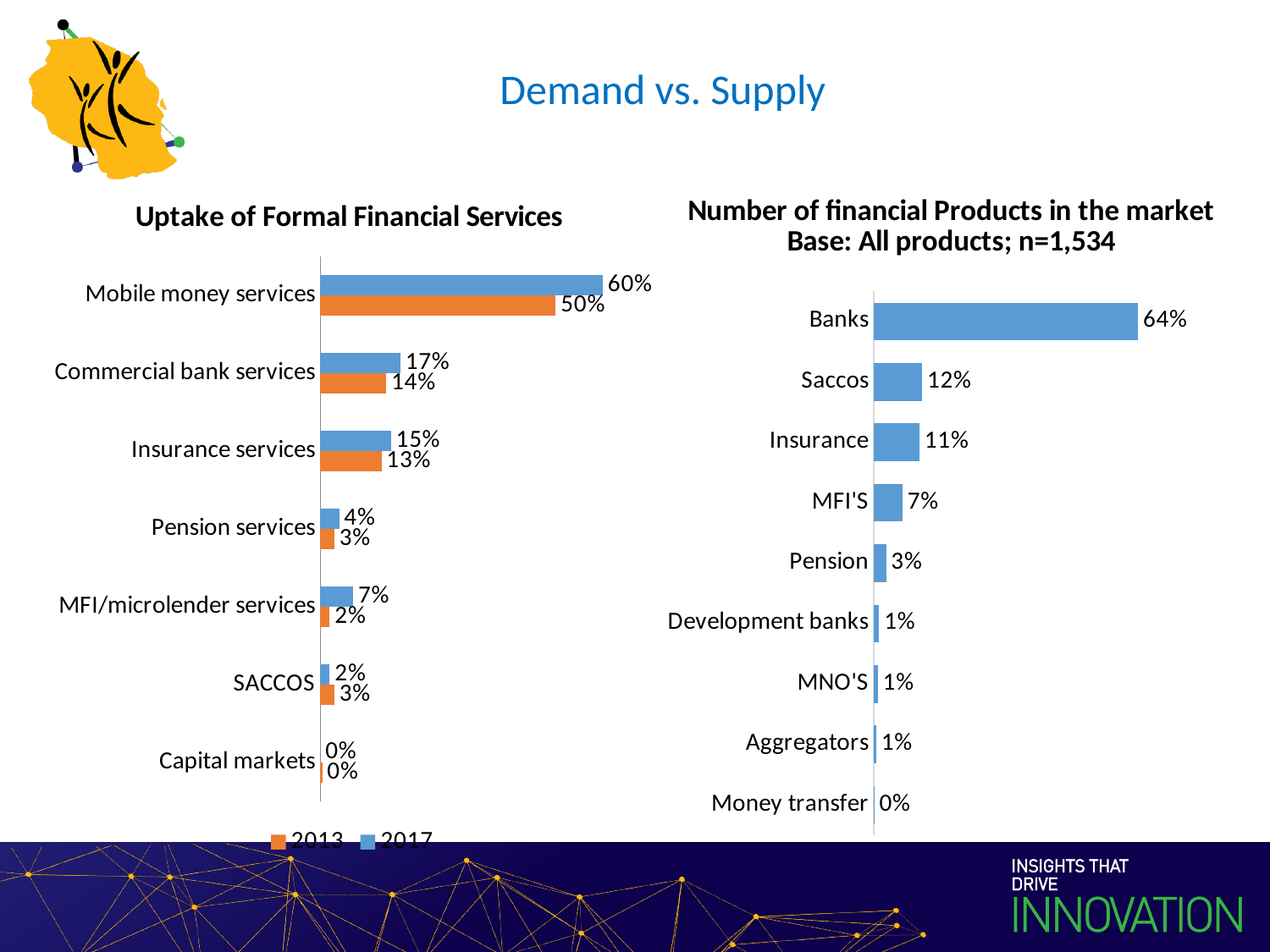
In the 'Number of financial Products in the market' chart, how many categories are shown? 9 In the 'Number of financial Products in the market' chart, what is the value for Banks? 64% In the 'Uptake of Formal Financial Services' chart, what is the 2013 value for Commercial bank services? 14% In the 'Uptake of Formal Financial Services' chart, how many categories are shown? 7 In the 'Uptake of Formal Financial Services' chart, what is the 2017 value for Mobile money services? 60% In the 'Uptake of Formal Financial Services' chart, how many series does the legend list? 2 In the 'Uptake of Formal Financial Services' chart, what is the difference between the 2017 and 2013 values for Mobile money services? 10% In the 'Uptake of Formal Financial Services' chart, which category has the highest 2017 value? Mobile money services In the 'Number of financial Products in the market' chart, which category has the lowest value? Money transfer In the 'Uptake of Formal Financial Services' chart, which is larger for SACCOS: the 2013 value or the 2017 value? 2013 In the 'Number of financial Products in the market' chart, what is the difference between Saccos and Insurance? 1% What kind of chart is the 'Number of financial Products in the market' chart? Bar chart